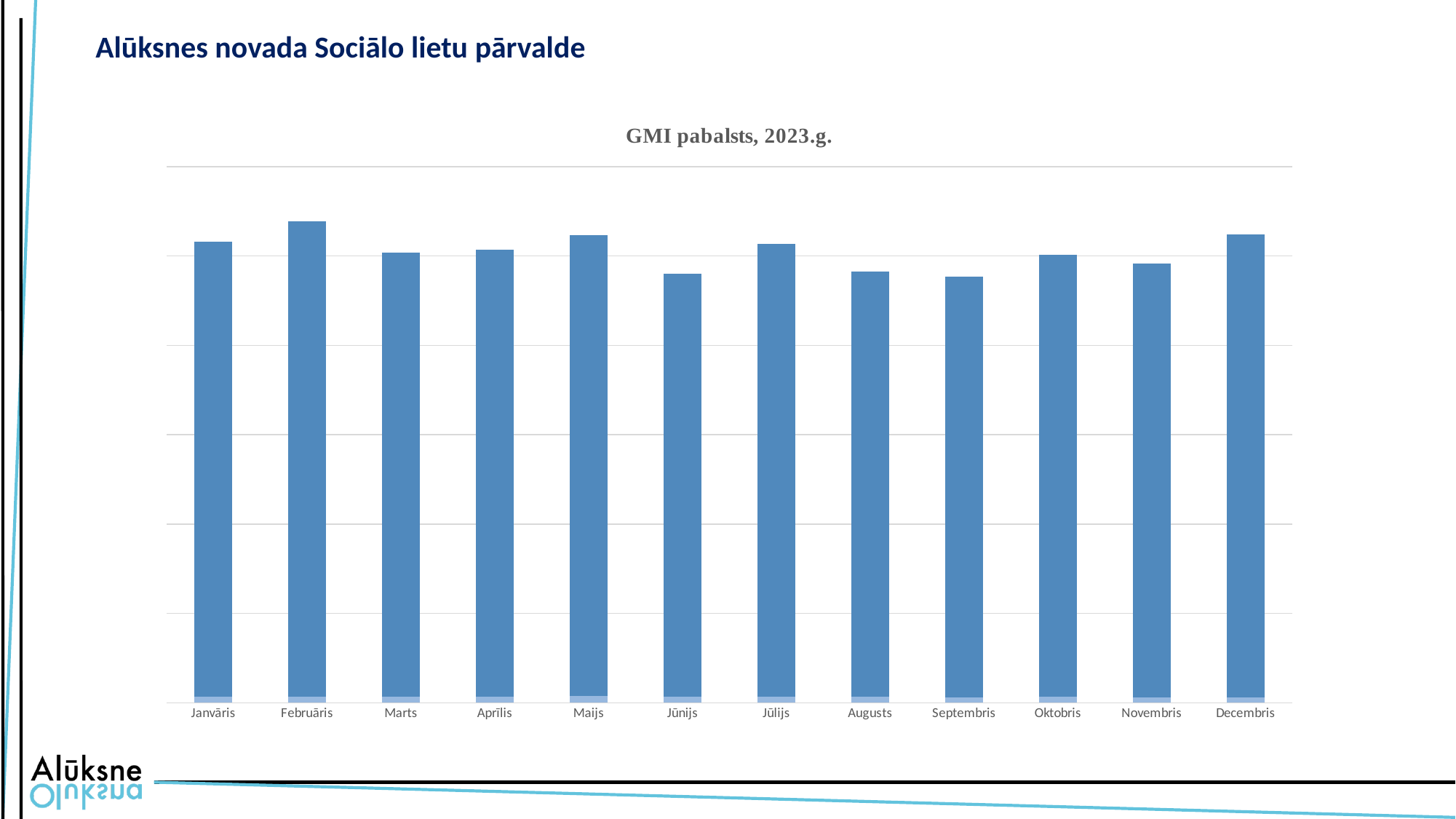
What is the label of the first category on the x axis? Janvāris Which month has the highest bar? Februāris Which bar is taller, Janvāris or Jūnijs? Janvāris Which bar is taller, Maijs or Septembris? Maijs What kind of chart is shown on the slide? bar chart What is the title of the chart? GMI pabalsts, 2023.g. What colour are the bars in the chart? blue Which bar is taller, Jūlijs or Augusts? Jūlijs How many months (categories) are plotted on the x axis? 12